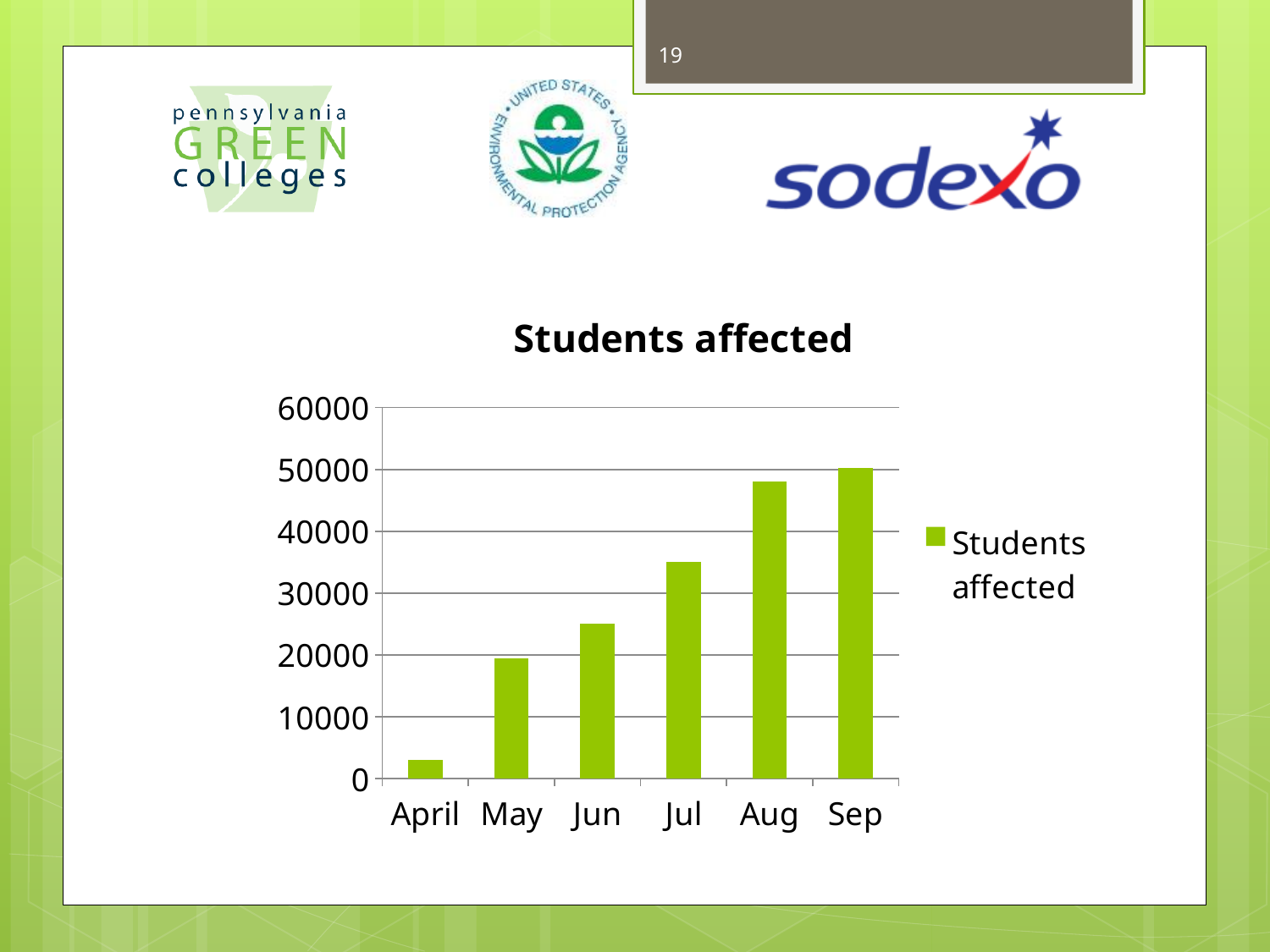
Is the value for April greater or less than 10000? less Which is larger, the value for May or the value for Jul? Jul Which month has the lowest number of students affected? April What is the title of the chart? Students affected How many months are shown on the x axis of the chart? 6 Which month has the highest number of students affected? Sep Is the value for Jul greater or less than 40000? less Do the values rise or fall from April to Sep? rise What type of chart is shown on the slide? bar chart Is the value for Aug greater or less than 40000? greater How many series does the legend list? 1